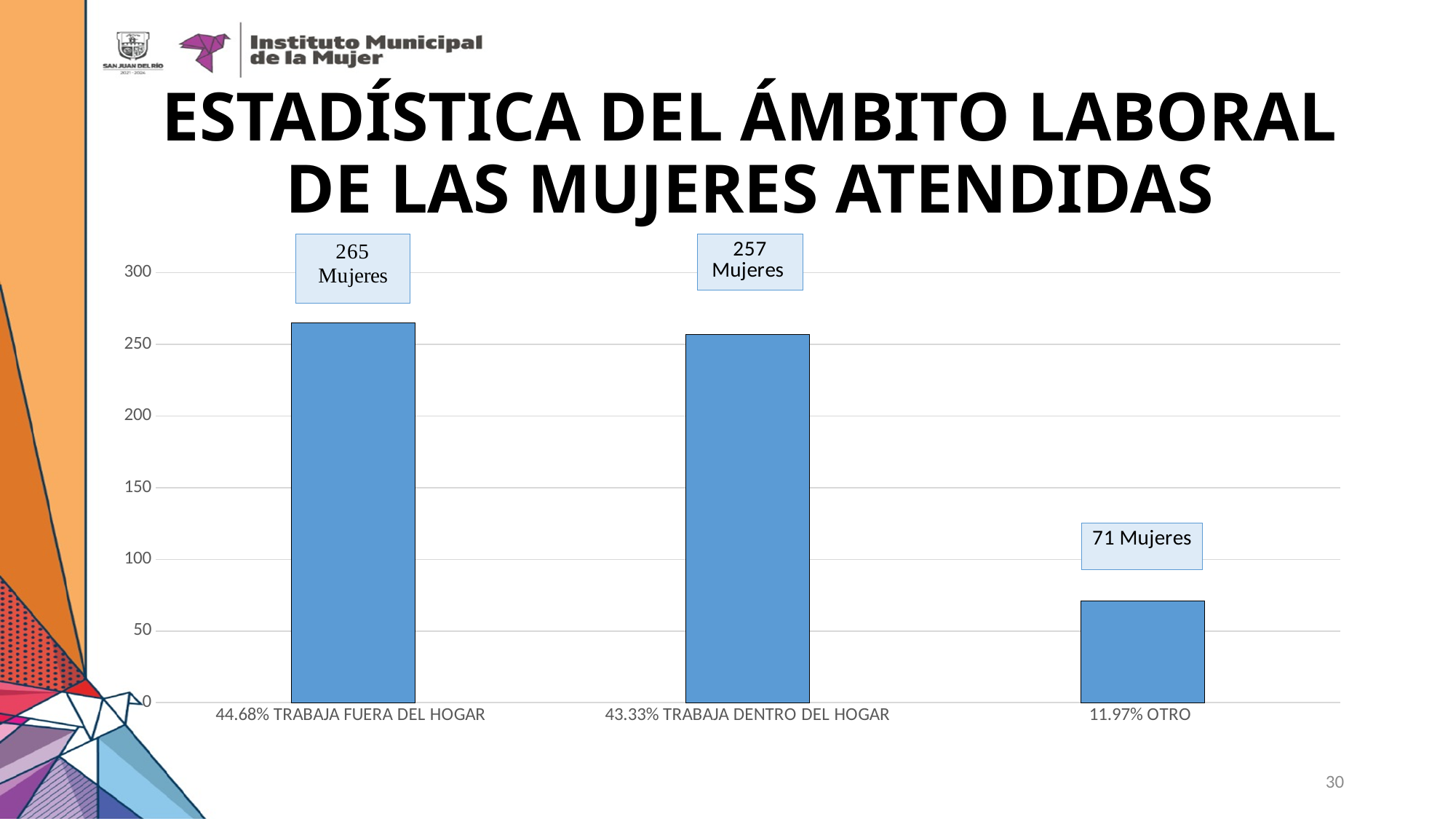
What percentage is shown for the 'OTRO' category on the x axis label? 11.97% What is the difference between the number of women who work outside the home and those who work inside the home? 8 Do the bar values rise or fall from left to right along the x axis? fall How many women are in the 'TRABAJA FUERA DEL HOGAR' category? 265 Mujeres What kind of chart is shown on the slide? bar chart How many categories does the chart show? 3 How many women are in the 'OTRO' category? 71 Mujeres Which is larger: the value for 'TRABAJA FUERA DEL HOGAR' or the value for 'TRABAJA DENTRO DEL HOGAR'? TRABAJA FUERA DEL HOGAR How many women are in the 'TRABAJA DENTRO DEL HOGAR' category? 257 Mujeres Which category has the highest number of women? 44.68% TRABAJA FUERA DEL HOGAR What is the difference between the 'TRABAJA DENTRO DEL HOGAR' value and the 'OTRO' value? 186 Which category has the lowest number of women? 11.97% OTRO